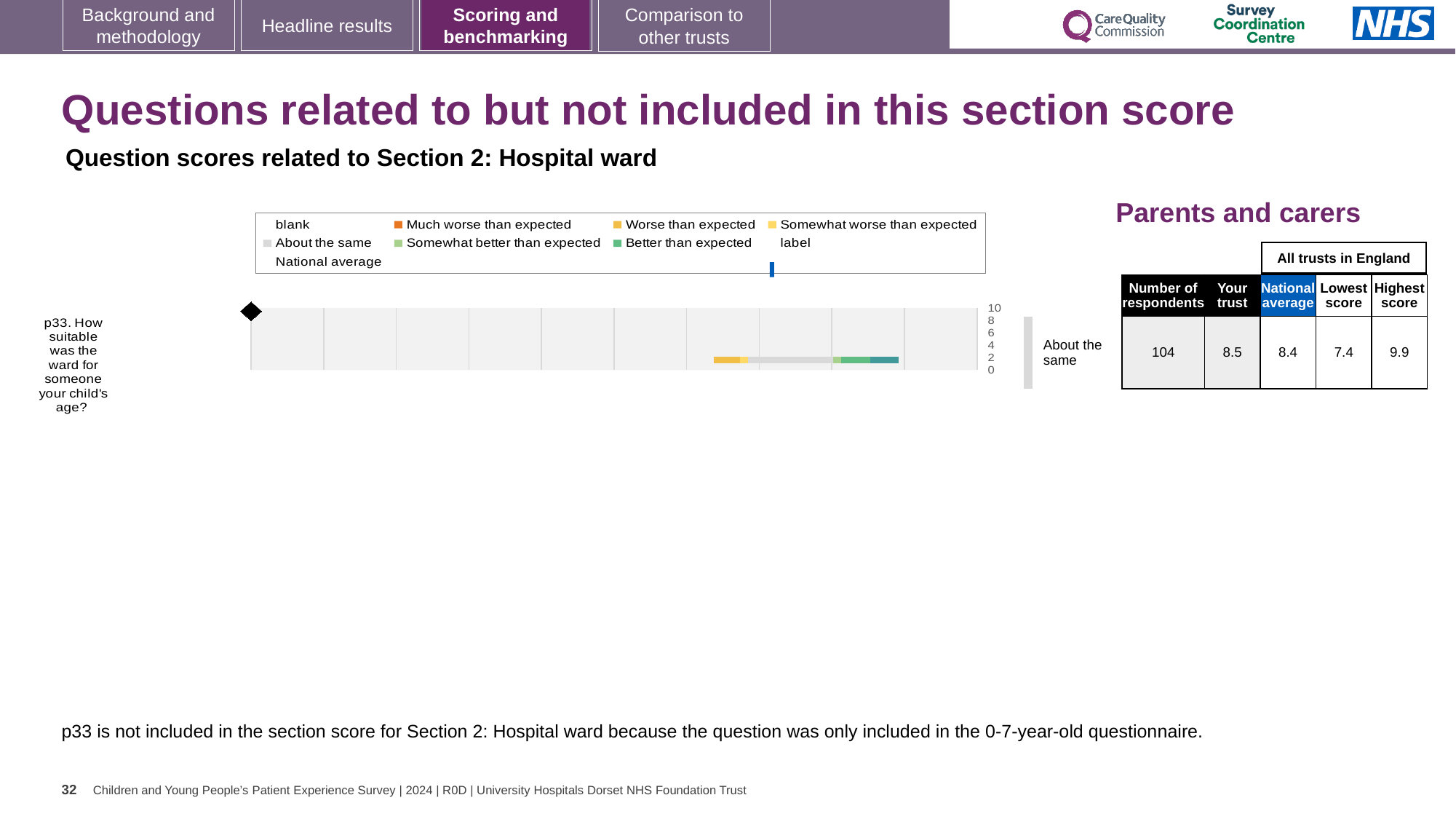
How many respondents answered question p33? 104 What is the score for 'Your trust' for question p33 (How suitable was the ward for someone your child's age?)? 8.5 What is the difference between the highest score and the lowest score for question p33? 2.5 What is the national average score for question p33? 8.4 Which respondent group does the chart relate to, according to the heading above the table? Parents and carers What is the highest score among all trusts in England for question p33? 9.9 What benchmark category label is shown for question p33? About the same What is the difference between the trust's score and the national average for question p33? 0.1 Which is larger for question p33: the trust's score or the national average? Your trust How many questions are plotted on the chart? 1 What kind of chart is used to show the question score for p33? Bar chart What is the lowest score among all trusts in England for question p33? 7.4